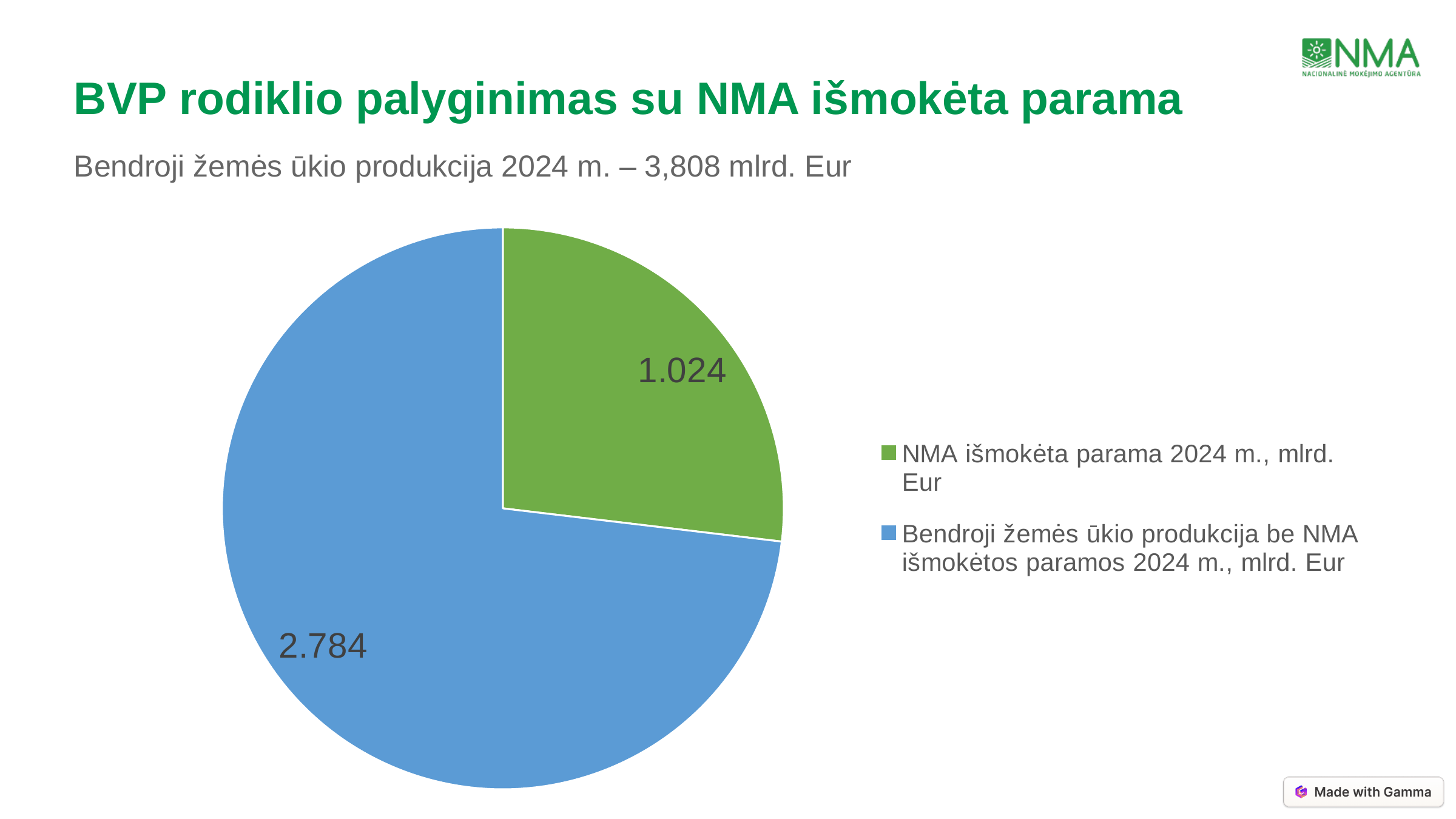
What is the difference between the value for Bendroji žemės ūkio produkcija be NMA išmokėtos paramos and the value for NMA išmokėta parama? 1.760 How many slices does the pie chart have? 2 What is the value of the slice for Bendroji žemės ūkio produkcija be NMA išmokėtos paramos 2024 m., mlrd. Eur? 2.784 Which slice is the largest in the pie chart? Bendroji žemės ūkio produkcija be NMA išmokėtos paramos 2024 m., mlrd. Eur What share of the pie does the NMA išmokėta parama slice represent? 26.9% What kind of chart is shown on the slide? pie chart Which is larger: the slice for NMA išmokėta parama or the slice for Bendroji žemės ūkio produkcija be NMA išmokėtos paramos? Bendroji žemės ūkio produkcija be NMA išmokėtos paramos Which slice is the smallest in the pie chart? NMA išmokėta parama 2024 m., mlrd. Eur What is the total of the two slices in the pie chart? 3.808 What is the value of the slice for NMA išmokėta parama 2024 m., mlrd. Eur? 1.024 How many entries does the legend list? 2 What colour is the slice for NMA išmokėta parama 2024 m., mlrd. Eur? green